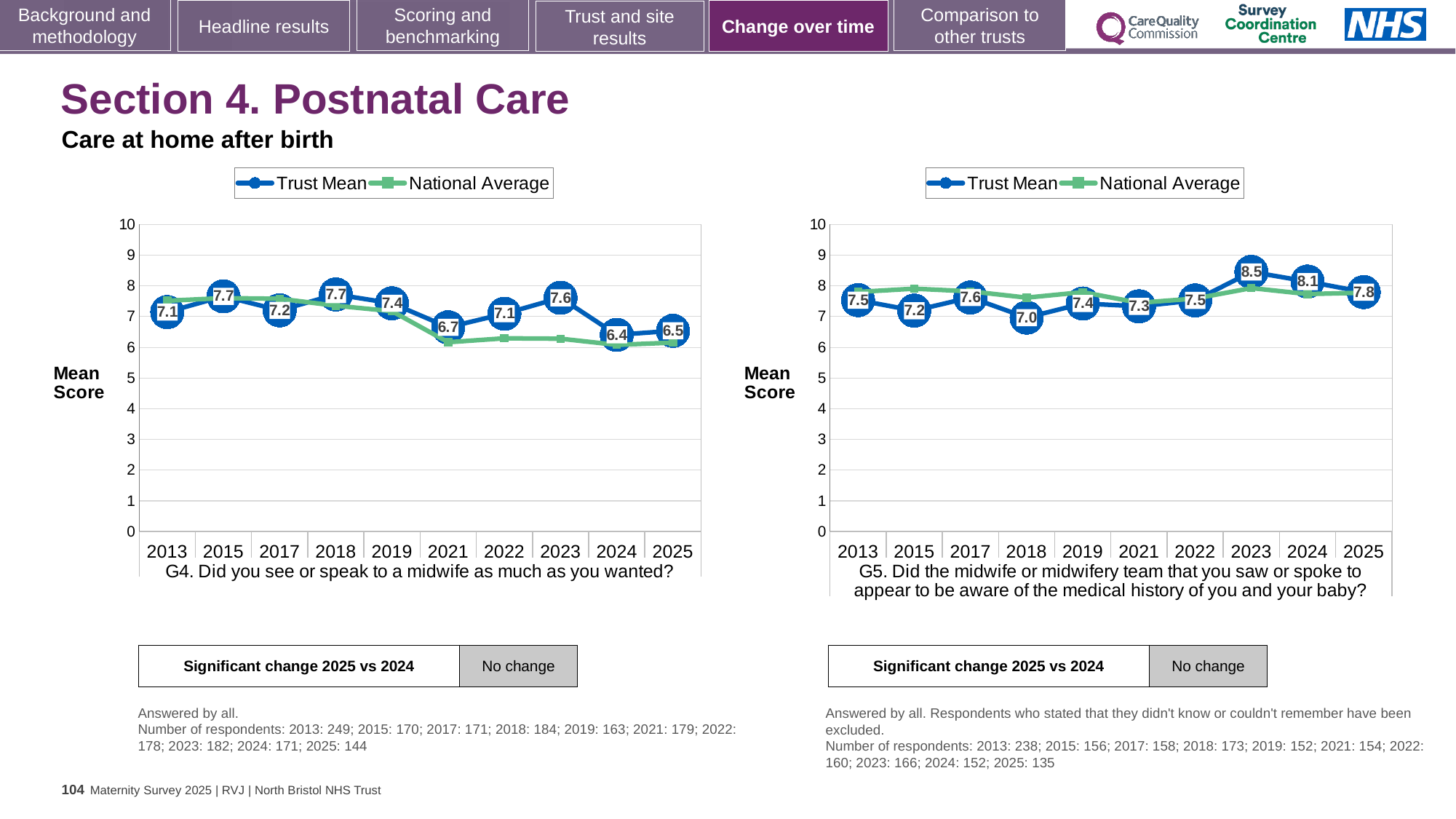
In the G4 chart, what is the Trust Mean score for 2025? 6.5 In the G5 chart, what is the difference between the Trust Mean scores for 2025 and 2013? 0.3 In the G4 chart, what is the Trust Mean score for 2021? 6.7 In the G4 chart, what is the difference between the Trust Mean scores for 2023 and 2024? 1.2 In the G5 chart, which year has the lowest Trust Mean score? 2018 How many years are plotted on the x axis of the G4 chart? 10 In the G5 chart, is the National Average for 2025 greater or less than 7? greater In the G5 chart, which year has the highest Trust Mean score? 2023 In the G4 chart, is the Trust Mean score for 2015 greater or less than the score for 2017? greater In the G4 chart, which year has the lowest Trust Mean score? 2024 In the G5 chart, what is the Trust Mean score for 2023? 8.5 How many series does the legend of the G5 chart list? 2